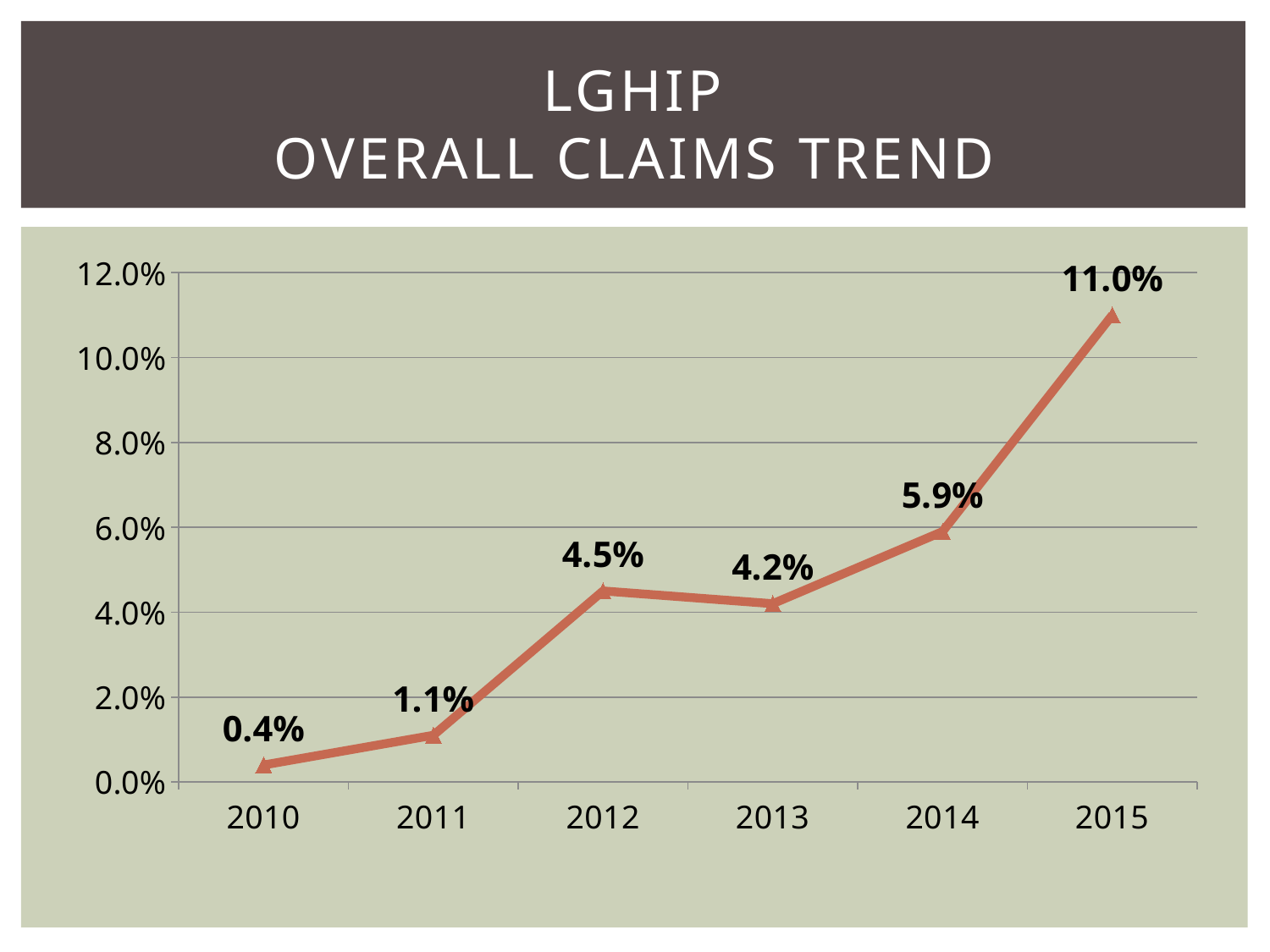
Which is larger, the value for 2011 or the value for 2013? 2013 Which year has the highest value? 2015 What is the value for 2012? 4.5% What is the difference between the values for 2015 and 2014? 5.1% How many years are plotted on the chart? 6 What is the value for 2014? 5.9% Which year has the lowest value? 2010 What kind of chart is shown on the slide? Line chart What is the value for 2010? 0.4% Is the value for 2015 greater or less than 10.0%? greater What is the difference between the values for 2012 and 2013? 0.3% What is the title of the slide? LGHIP Overall Claims Trend